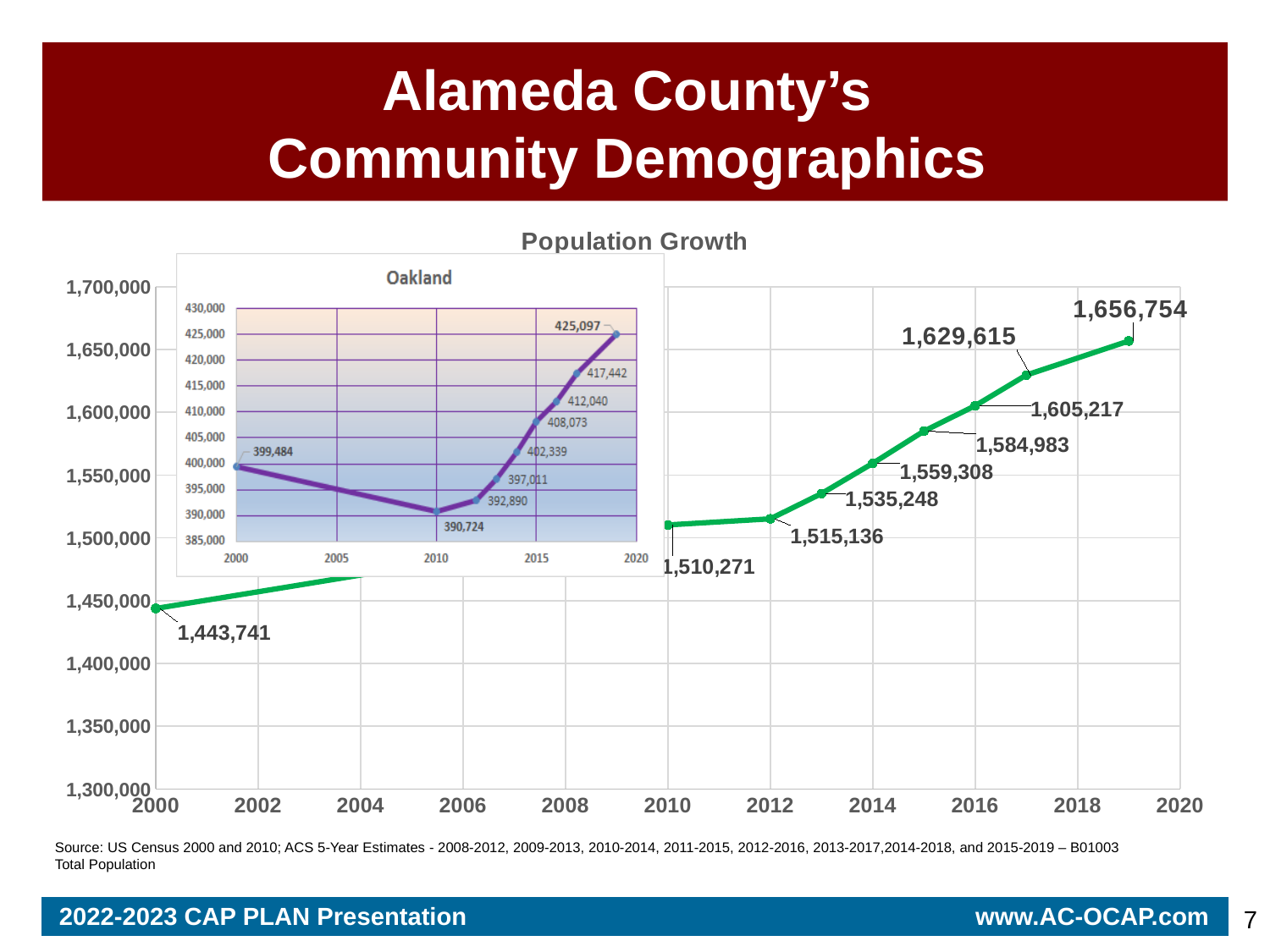
In the inset Oakland chart, what is the value labeled for the year 2000? 399,484 In the Population Growth chart, what is the lowest labeled population value? 1,443,741 In the inset Oakland chart, what is the highest labeled value? 425,097 In the Population Growth chart, how many data points are labeled with values? 9 In the Population Growth chart, do the values generally rise or fall from 2000 to 2020? rise In the Population Growth chart, what is the population value labeled for the year 2000? 1,443,741 In the Population Growth chart, which is larger: the value labeled 1,584,983 or the value labeled 1,605,217? 1,605,217 In the Population Growth chart, what is the population value labeled for the year 2010? 1,510,271 What kind of chart is the Population Growth chart? line chart In the Population Growth chart, what is the difference between the 2010 value (1,510,271) and the 2000 value (1,443,741)? 66,530 In the Population Growth chart, what is the highest labeled population value? 1,656,754 In the inset Oakland chart, what is the lowest labeled value? 390,724